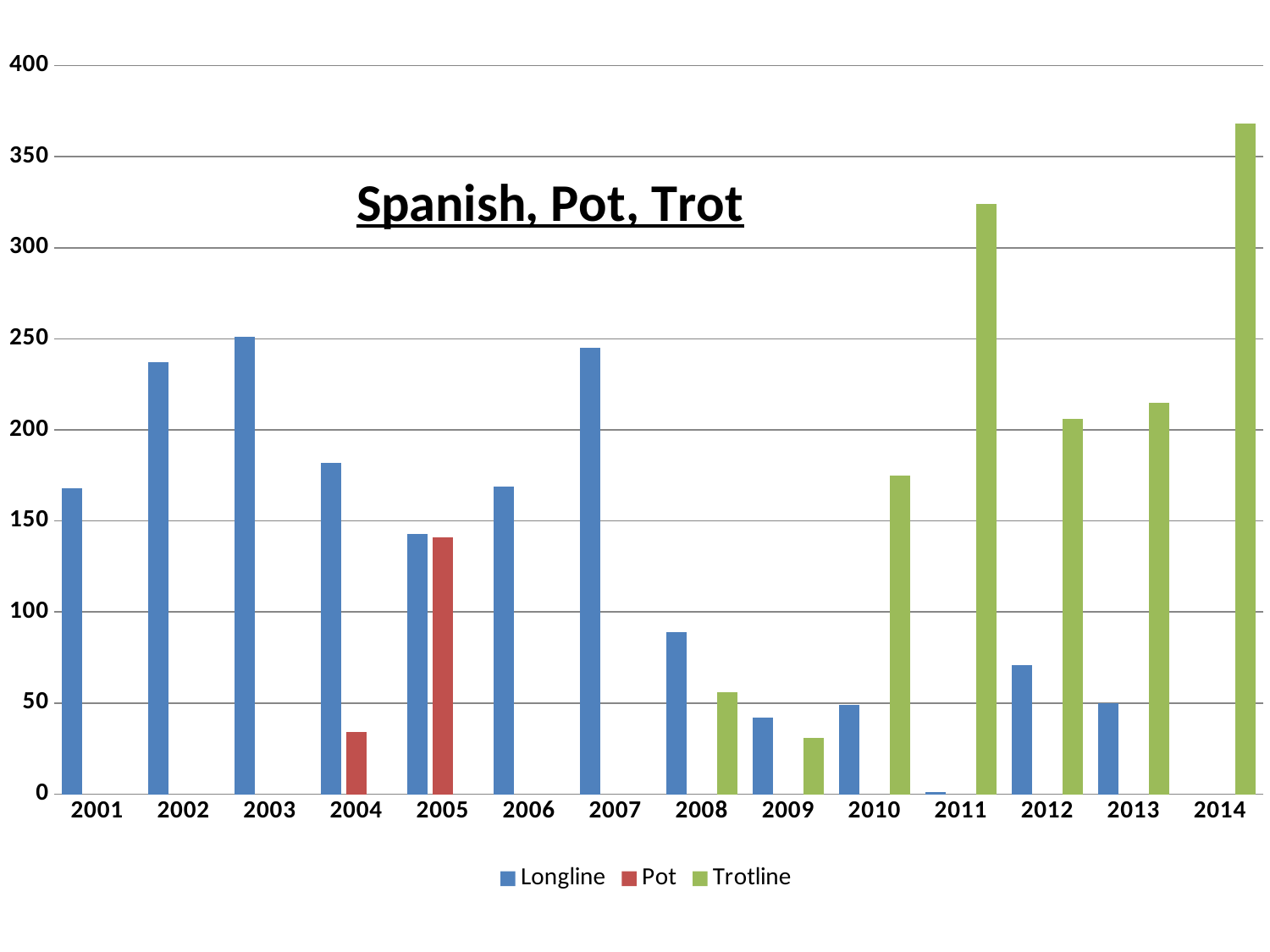
In which year is the Trotline value highest? 2014 Is the Longline value for 2002 greater or less than 200? greater How many years are shown along the x axis? 14 Which year has the larger Pot value, 2004 or 2005? 2005 How many series does the legend list? 3 In 2010, which series has the larger value, Longline or Trotline? Trotline Is the Longline value for 2008 greater or less than 100? less Is the Trotline value for 2011 greater or less than 300? greater In which year is the Trotline value lowest? 2009 What kind of chart is shown on the slide? bar chart What is the title of the chart? Spanish, Pot, Trot In which year is the Longline value highest? 2003